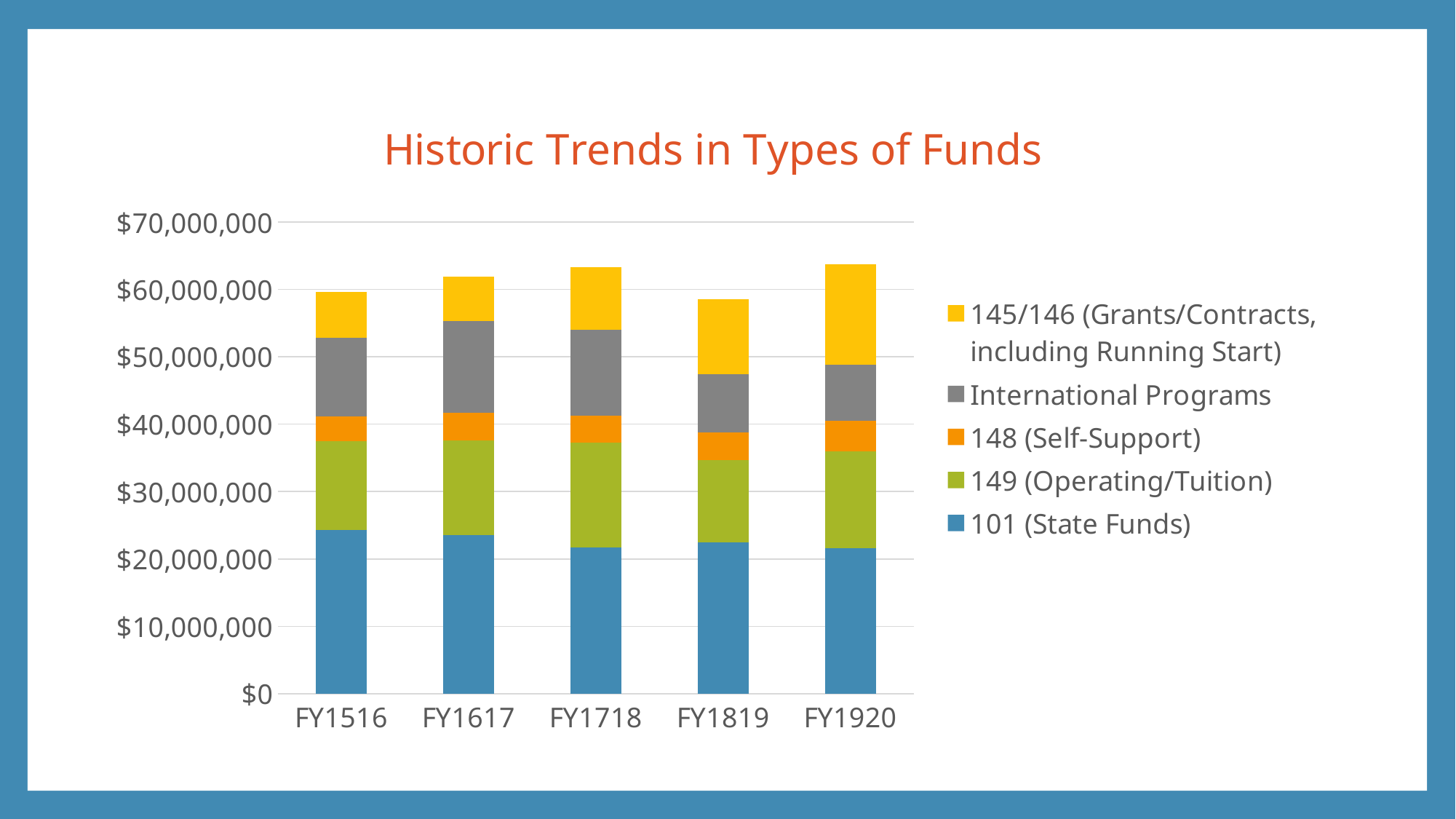
Which series is shown at the bottom of each stacked bar? 101 (State Funds) Is the 101 (State Funds) value for FY1516 greater or less than $20,000,000? greater What kind of chart is shown on the slide? Stacked bar chart Is the 101 (State Funds) value for FY1718 greater or less than $30,000,000? less Does the 145/146 (Grants/Contracts, including Running Start) segment generally rise or fall from FY1516 to FY1920? rise How many series does the legend list? 5 Is the total stacked value for FY1819 greater or less than $60,000,000? less What is the title of the chart? Historic Trends in Types of Funds How many fiscal years are shown on the x axis? 5 Which year has the larger 145/146 (Grants/Contracts, including Running Start) segment, FY1516 or FY1920? FY1920